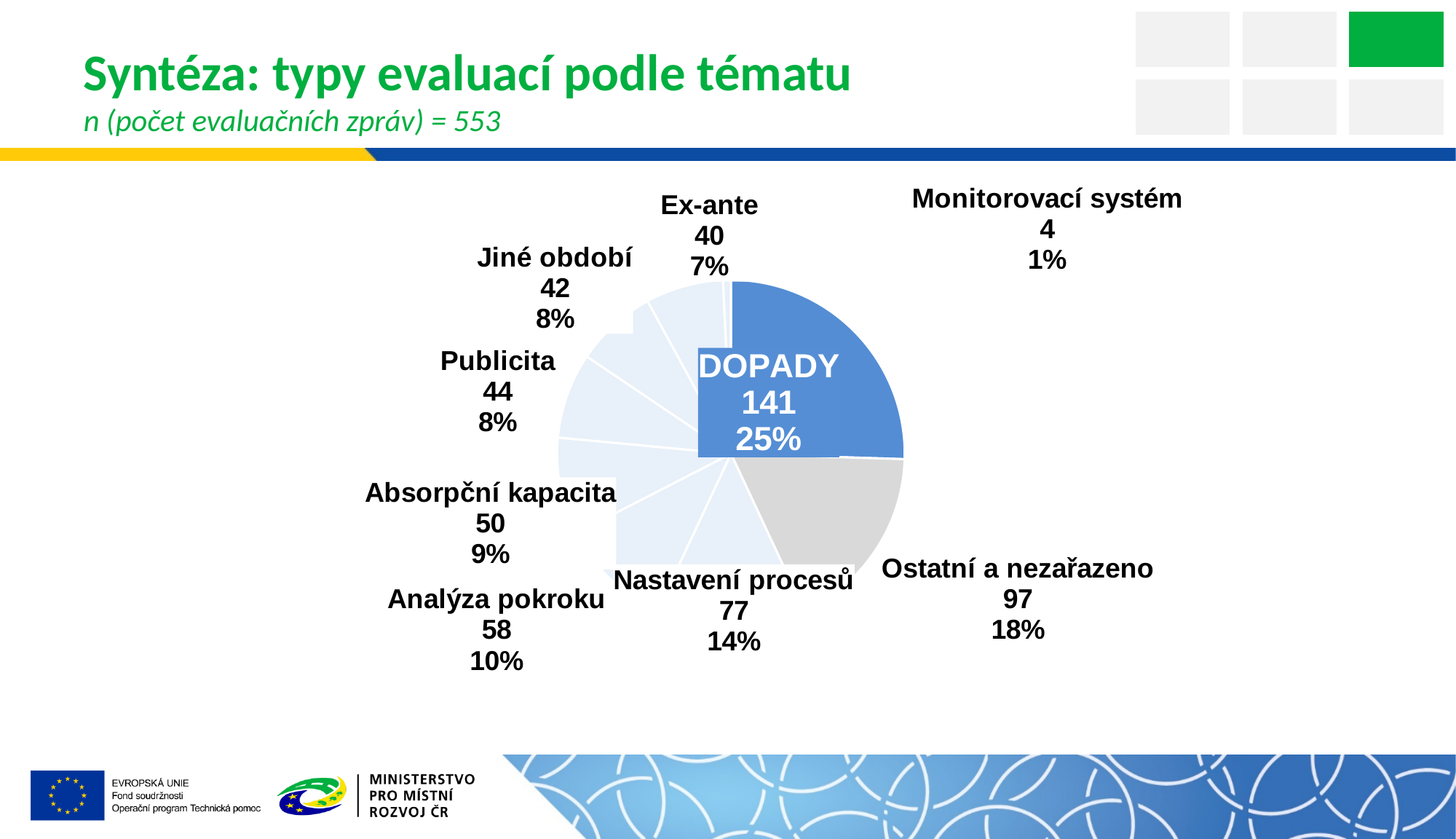
What type of chart is shown on the slide? pie chart How many categories are shown in the pie chart? 9 What is the value for Monitorovací systém? 4 What percentage is shown for Analýza pokroku? 10% What is the title of the slide containing the chart? Syntéza: typy evaluací podle tématu Which category has the largest slice of the pie? DOPADY What is the difference between the values for Absorpční kapacita and Publicita? 6 Which is larger, the value for Jiné období or the value for Ex-ante? Jiné období What is the value for Nastavení procesů? 77 Which category has the smallest slice of the pie? Monitorovací systém What share of the pie does Ostatní a nezařazeno represent? 18% How many evaluation reports are in the DOPADY category? 141